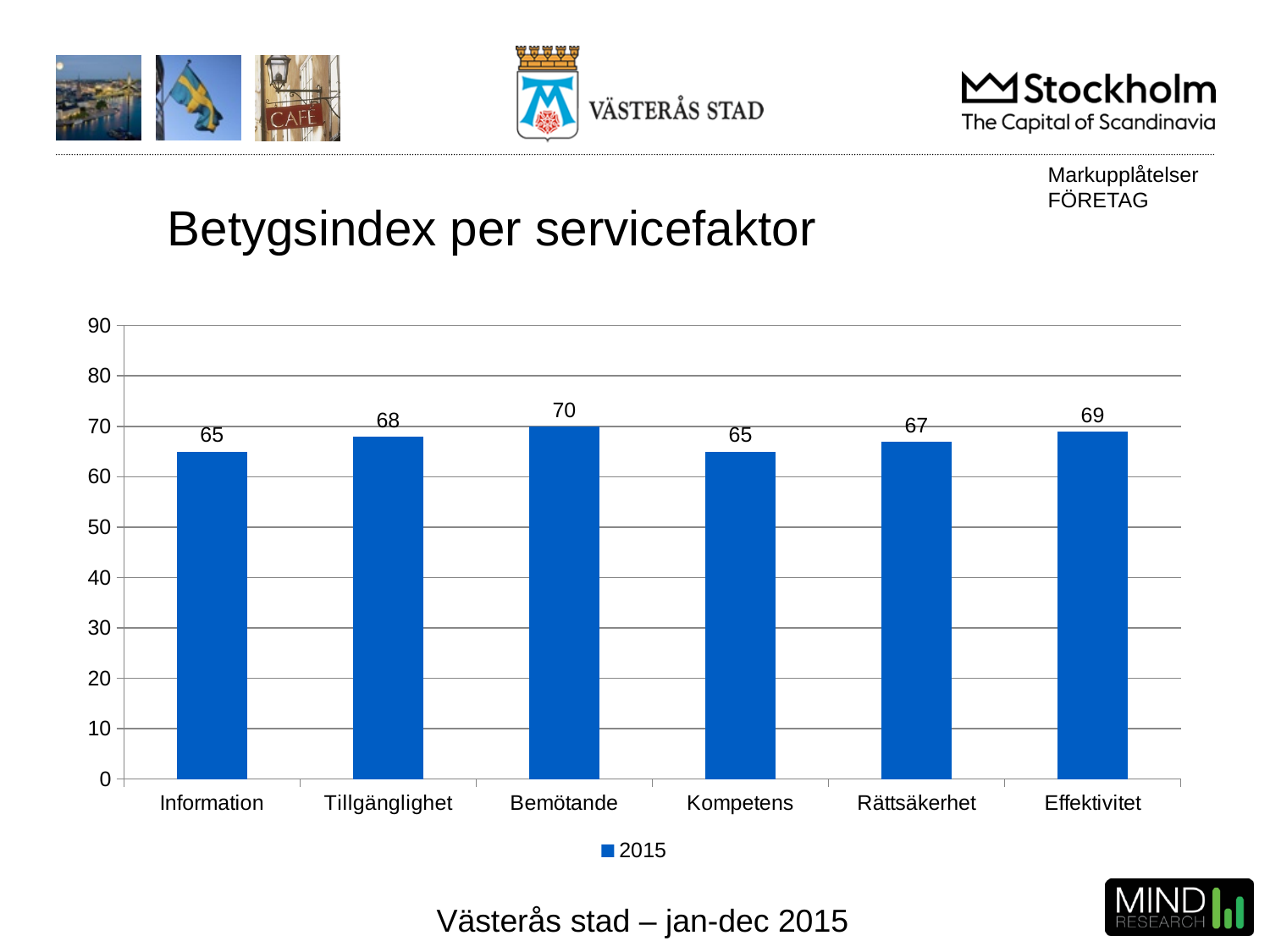
How many service factors are shown on the x axis? 6 What is the value for Rättsäkerhet? 67 What kind of chart is shown on the slide? bar chart What is the value for Tillgänglighet? 68 Is the value for Effektivitet greater or less than 60? greater What is the title of the chart? Betygsindex per servicefaktor Which service factor has the highest index? Bemötande What is the value for Bemötande? 70 Which is larger, the value for Tillgänglighet or the value for Kompetens? Tillgänglighet What is the difference between the values for Bemötande and Information? 5 How many series does the legend list? 1 What is the difference between the values for Effektivitet and Rättsäkerhet? 2